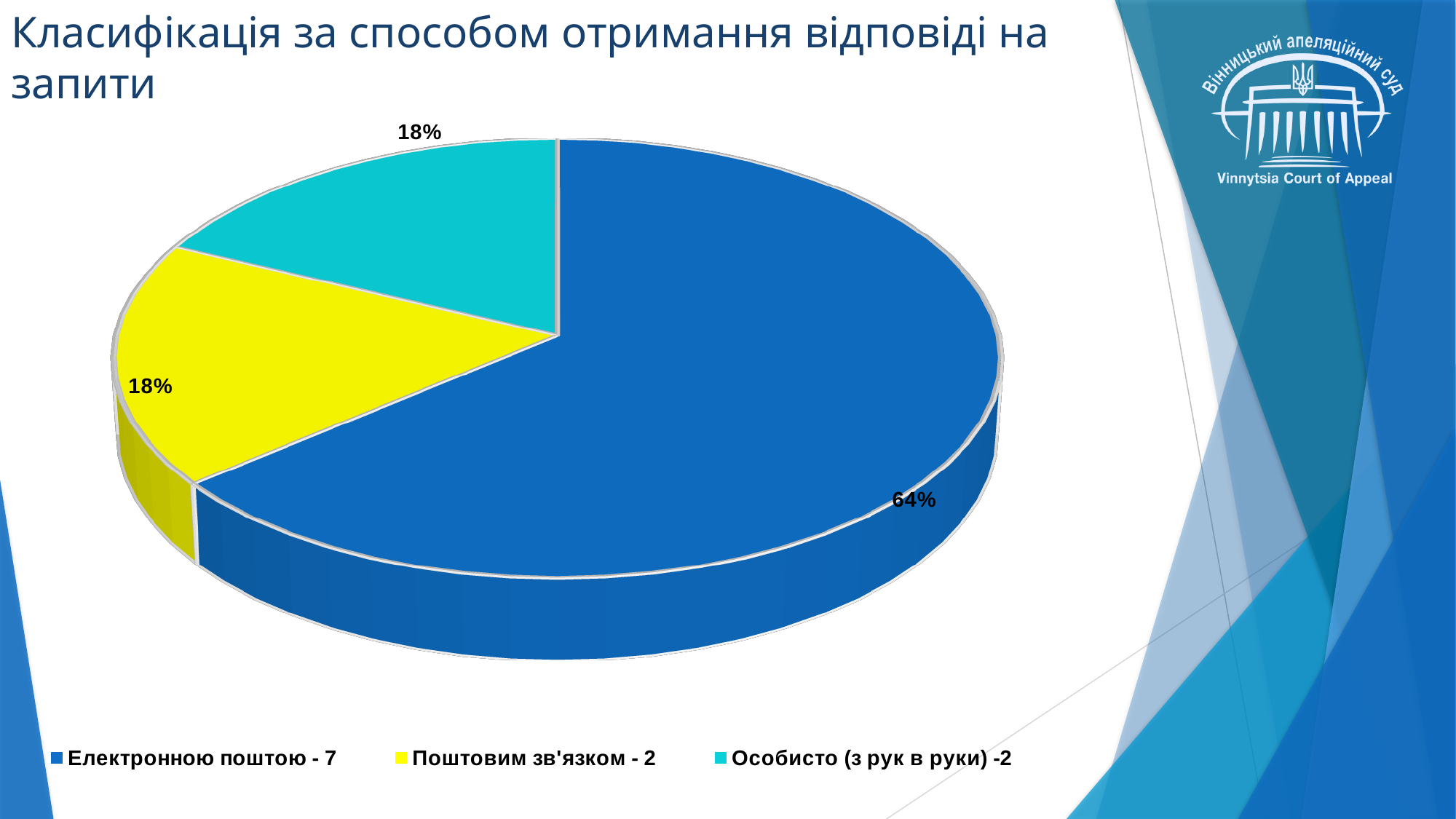
What share of the pie does the "Особисто (з рук в руки)" slice represent? 18% Which category has the largest slice of the pie? Електронною поштою What share of the pie does the "Електронною поштою" slice represent? 64% What colour is the "Поштовим зв'язком" slice? Yellow According to the legend, how many responses were received by "Електронною поштою"? 7 What share of the pie does the "Поштовим зв'язком" slice represent? 18% According to the legend, how many responses were received by "Поштовим зв'язком"? 2 Which slice is larger: "Електронною поштою" or "Особисто (з рук в руки)"? Електронною поштою What kind of chart is shown on the slide? Pie chart What is the total number of responses across all three legend categories? 11 What is the difference in percentage points between the "Електронною поштою" slice and the "Поштовим зв'язком" slice? 46% How many slices does the pie chart have? 3